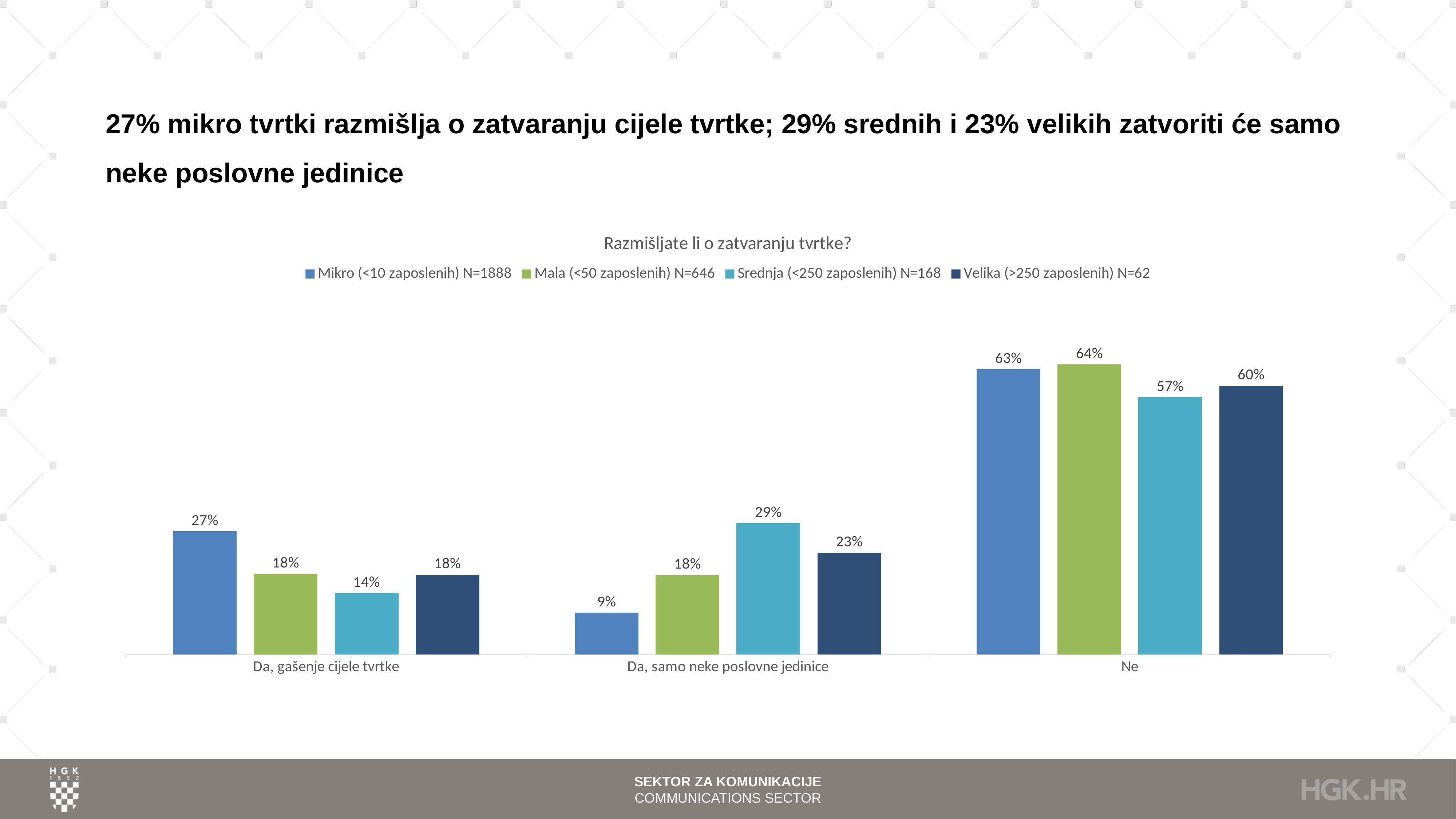
What kind of chart is shown on the slide? Bar chart Which series has the highest value in the 'Ne' category? Mala (<50 zaposlenih) N=646 What is the value for Srednja (<250 zaposlenih) in the 'Da, samo neke poslovne jedinice' category? 29% How many categories are shown on the x axis? 3 What is the title of the chart? Razmišljate li o zatvaranju tvrtke? In the 'Ne' category, which is larger: the value for Mikro or the value for Srednja? Mikro How many series does the legend list? 4 Which series has the lowest value in the 'Da, samo neke poslovne jedinice' category? Mikro (<10 zaposlenih) N=1888 What is the value for Mikro (<10 zaposlenih) in the 'Da, gašenje cijele tvrtke' category? 27% What is the sample size (N) for the Velika (>250 zaposlenih) series in the legend? 62 What is the value for Velika (>250 zaposlenih) in the 'Ne' category? 60% What is the difference between the Mikro and Srednja values in the 'Da, gašenje cijele tvrtke' category? 13%